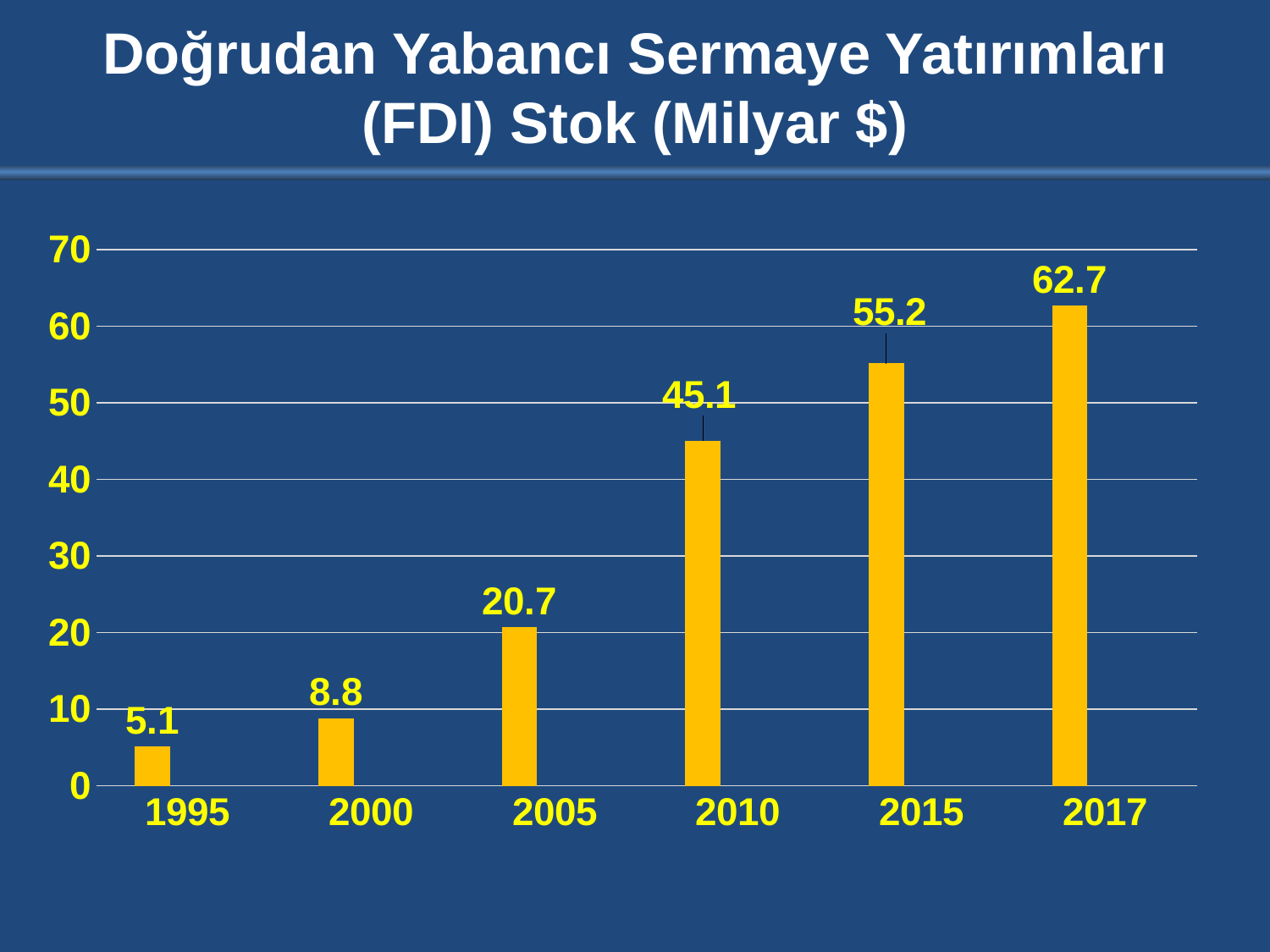
What is the difference between the FDI stock values for 2000 and 1995? 3.7 What is the FDI stock value for 2017? 62.7 What is the FDI stock value for 2005? 20.7 What is the FDI stock value for 1995? 5.1 Is the value for 2015 greater or less than 50? greater What is the difference between the FDI stock values for 2015 and 2010? 10.1 How many years are shown on the x axis? 6 Which year has the lowest FDI stock value? 1995 Do the FDI stock values rise or fall from 1995 to 2017? rise Which is larger, the FDI stock value for 2005 or for 2010? 2010 Which year has the highest FDI stock value? 2017 What kind of chart is shown on the slide? bar chart